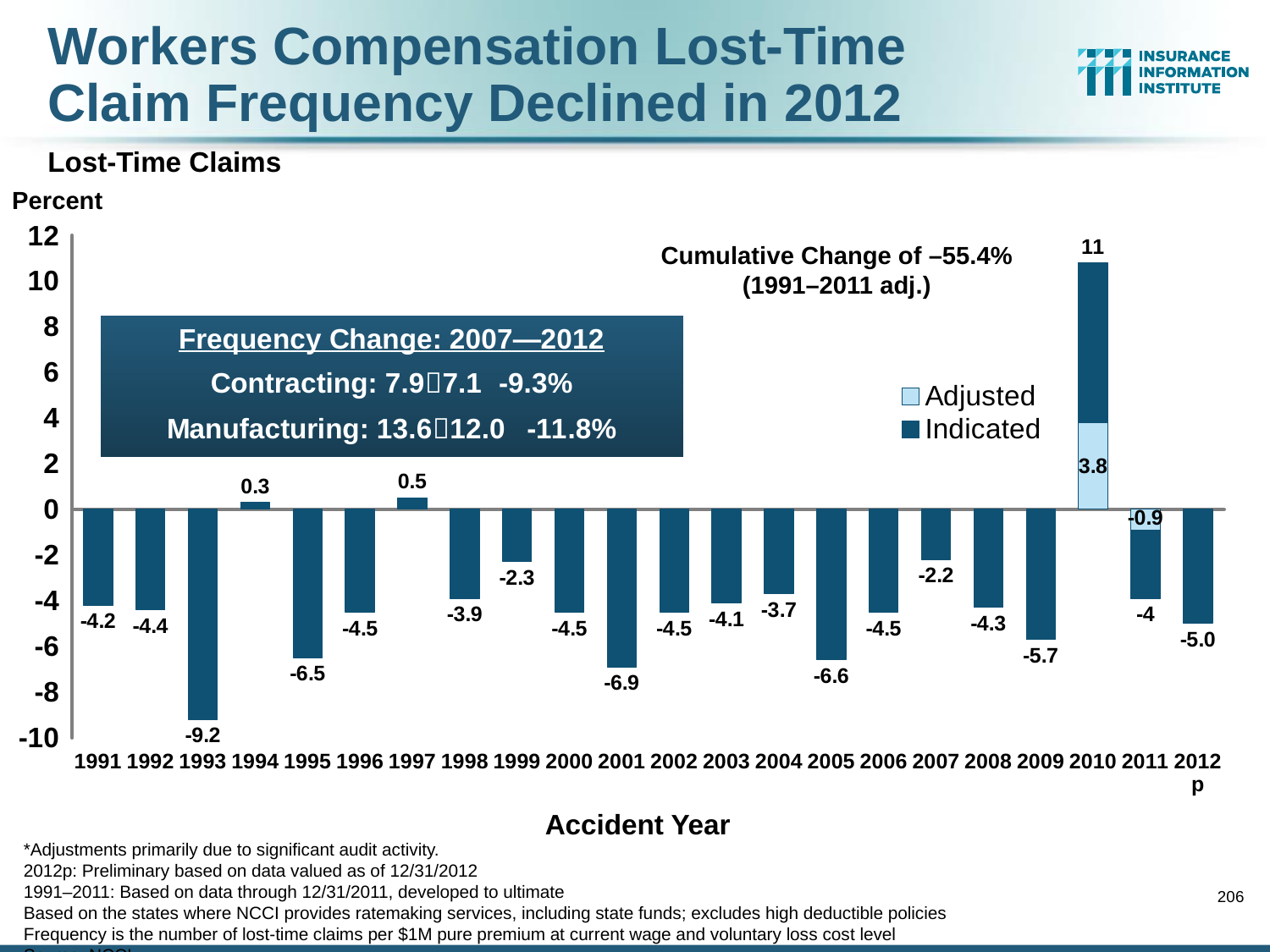
Which accident year has the highest indicated percent change in lost-time claim frequency? 2010 Which accident year has the larger value, 2005 or 2009? 2009 Which accident year has the lowest (most negative) percent change in lost-time claim frequency? 1993 How many series does the chart legend list? 2 What is the indicated percent change in lost-time claim frequency for accident year 1993? -9.2 What is the percent change in lost-time claim frequency for accident year 2001? -6.9 What are the two entries in the chart legend? Adjusted and Indicated What is the adjusted value shown for accident year 2011? -0.9 What is the adjusted value shown for accident year 2010? 3.8 What is the difference between the values for 1993 and 2001? 2.3 What kind of chart is used to show the lost-time claim frequency changes? Bar chart How many accident years are shown on the x axis of the chart? 22